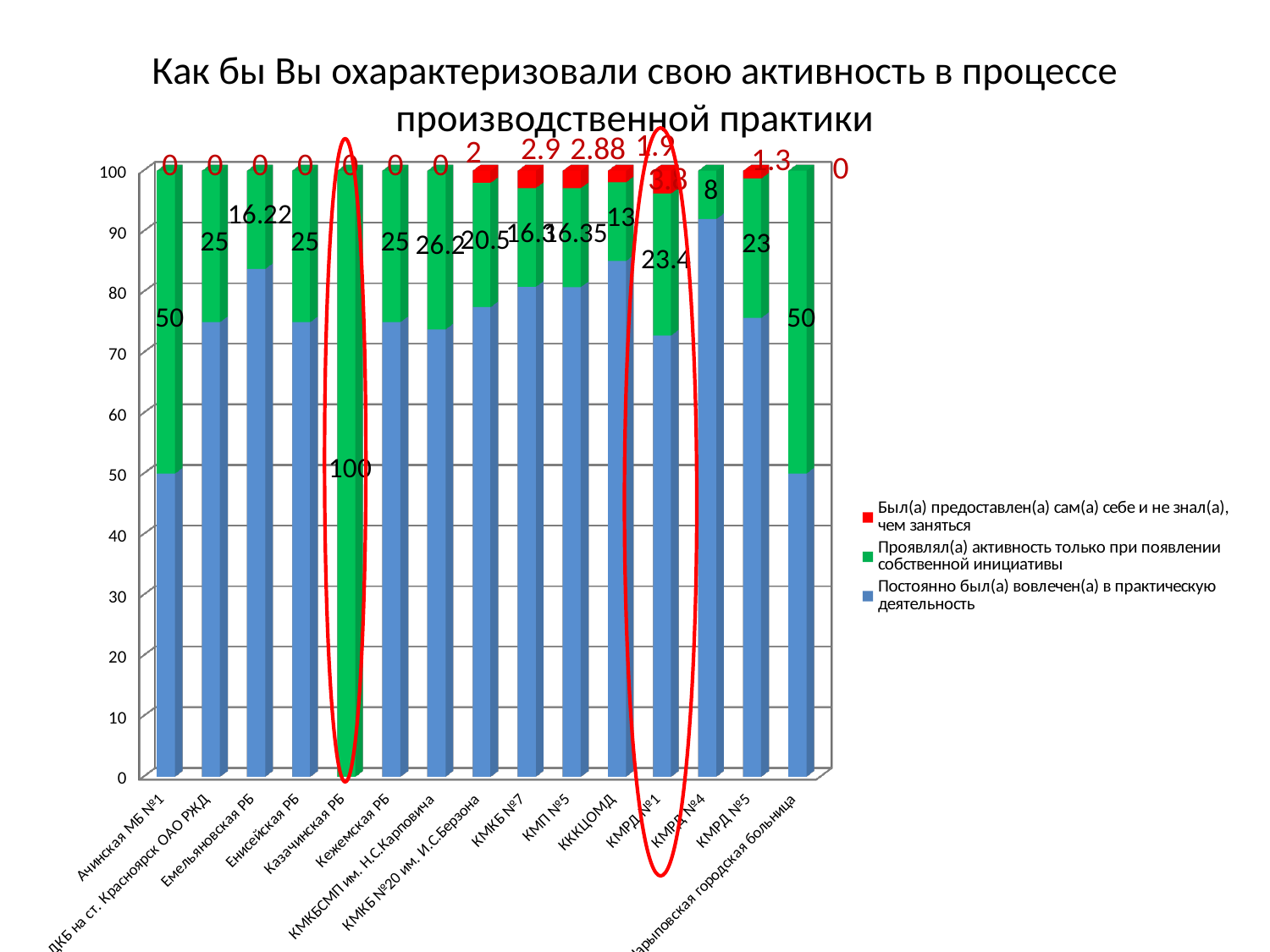
How many series does the legend list? 3 What is the difference between the green-series values for Ачинская МБ №1 and КМРД №4? 42 Which category has the highest value for the green series (Проявлял(а) активность только при появлении собственной инициативы)? Казачинская РБ Which category has the lowest value for the green series? КМРД №4 Which colour represents the series 'Был(а) предоставлен(а) сам(а) себе и не знал(а), чем заняться'? red What is the value of the green series for КМРД №1? 23.4 How many categories (organisations) are shown along the x axis? 15 What is the value of the green series (Проявлял(а) активность только при появлении собственной инициативы) for Казачинская РБ? 100 Is the value of the blue series (Постоянно был(а) вовлечен(а) в практическую деятельность) for Ачинская МБ №1 greater or less than 60? less What is the value of the green series for Емельяновская РБ? 16.22 Which has the larger green-series value: Ачинская МБ №1 or КМРД №5? Ачинская МБ №1 What kind of chart is shown on the slide? stacked bar chart